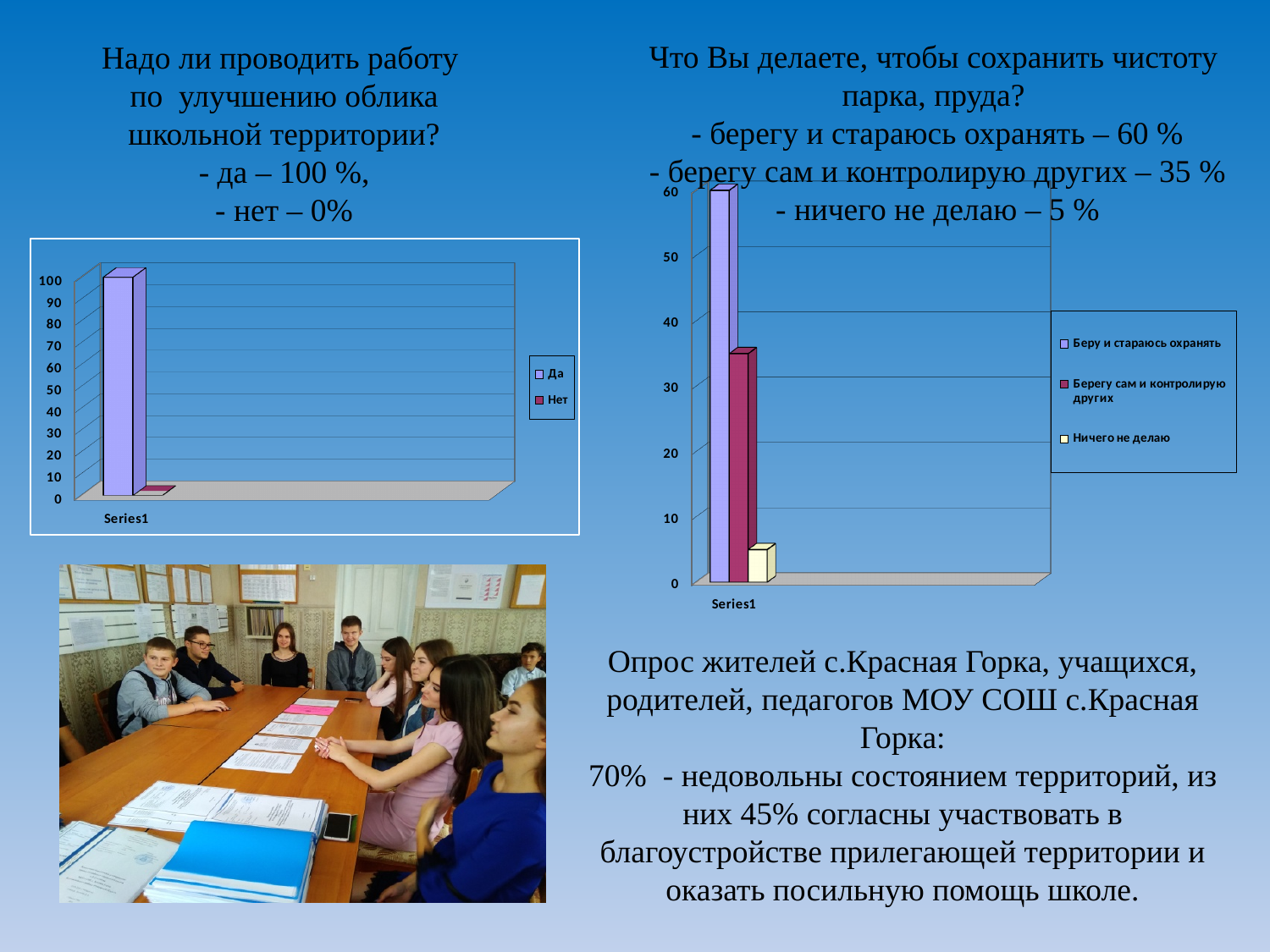
How many series does the legend of the right chart list? 3 In the right chart, is the value for Ничего не делаю greater or less than 10? less What kind of chart is the chart on the right side of the slide? bar chart In the right chart, is the value for Берегу сам и контролирую других greater or less than 30? greater What kind of chart is the chart on the left side of the slide? bar chart How many series does the legend of the left chart list? 2 In the left chart, what is the value for Нет? 0 In the left chart, what is the value for Да? 100 In the right chart, which series has the highest value? Беру и стараюсь охранять In the right chart, which series has the lowest value? Ничего не делаю In the left chart, which series is higher, Да or Нет? Да In the right chart, what is the value for Беру и стараюсь охранять? 60